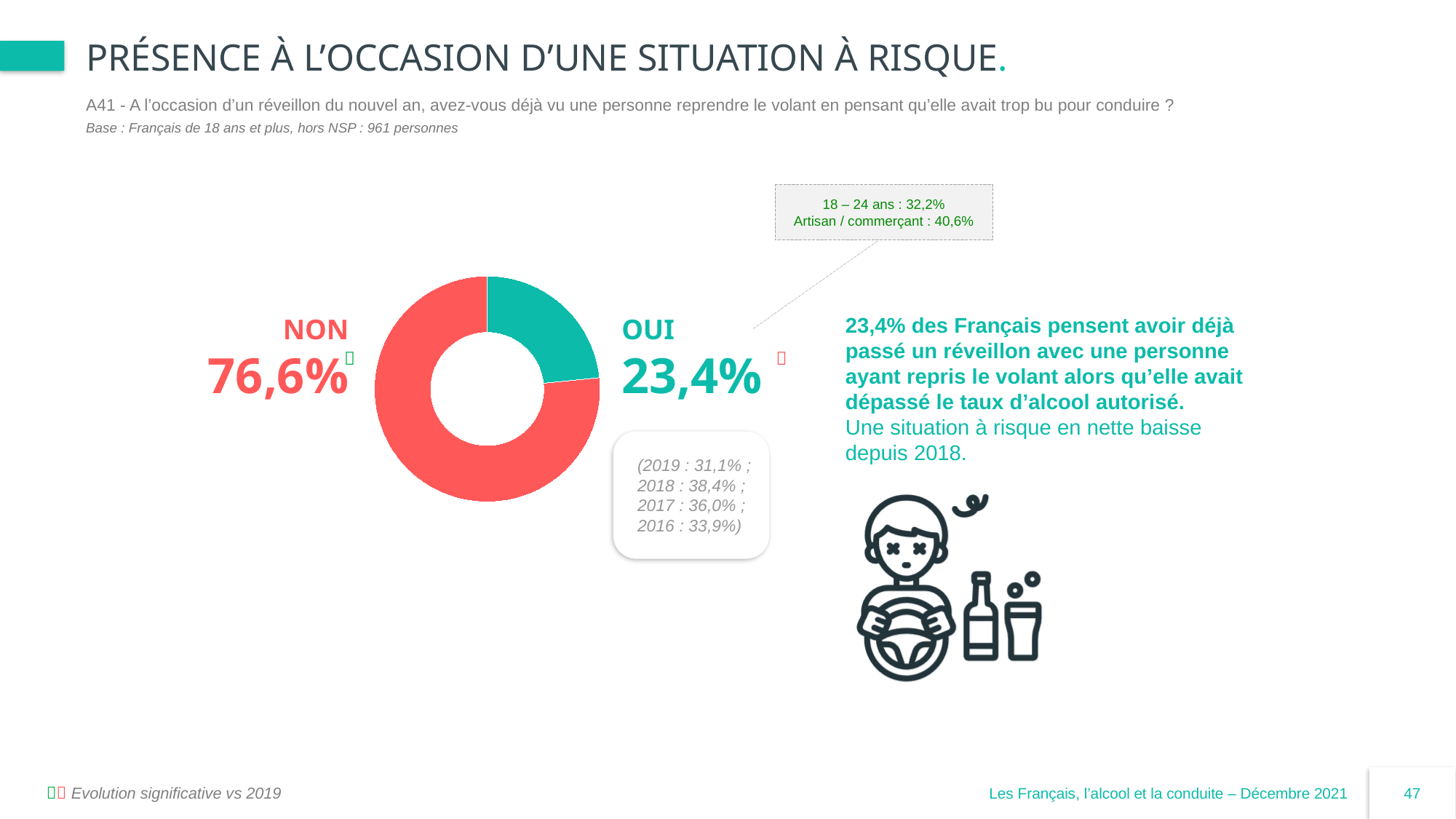
What was the OUI value in 2019, according to the note next to the chart? 31,1% What is the value for OUI in the doughnut chart? 23,4% Which is larger, the OUI share or the NON share? NON What is the OUI value for the 18 – 24 ans group shown in the callout box? 32,2% Which category has the largest share of the doughnut chart? NON How many categories does the doughnut chart show? 2 What colour is the OUI segment of the doughnut chart? Teal (green) What was the OUI value in 2018, according to the note next to the chart? 38,4% What is the value for NON in the doughnut chart? 76,6% Which category has the smallest share of the doughnut chart? OUI What is the difference between the NON and OUI shares? 53,2 points What kind of chart is shown on the slide? Doughnut chart